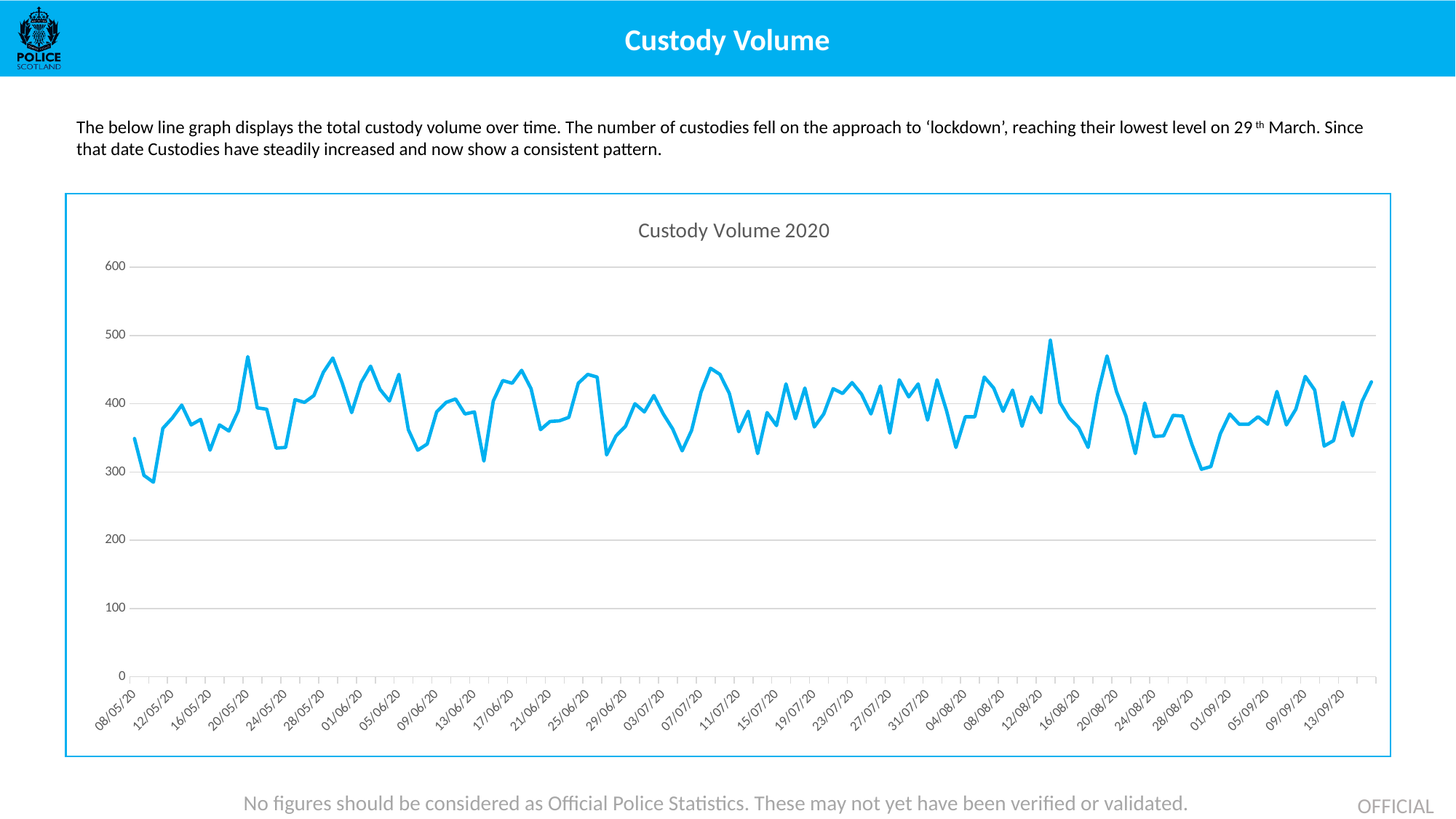
What is the highest value shown on the vertical axis? 600 What is the first date shown on the horizontal axis? 08/05/20 Is the value for 12/08/20 larger or smaller than the value for 08/05/20? larger What is the last date labelled on the horizontal axis? 13/09/20 Is the value for 08/05/20 greater or less than 300? greater Is the value for 12/08/20 greater or less than 450? less What is the title of the chart? Custody Volume 2020 Is the value for 08/05/20 greater or less than 400? less How many data series are plotted in the chart? 1 What kind of chart is shown on the slide? Line chart